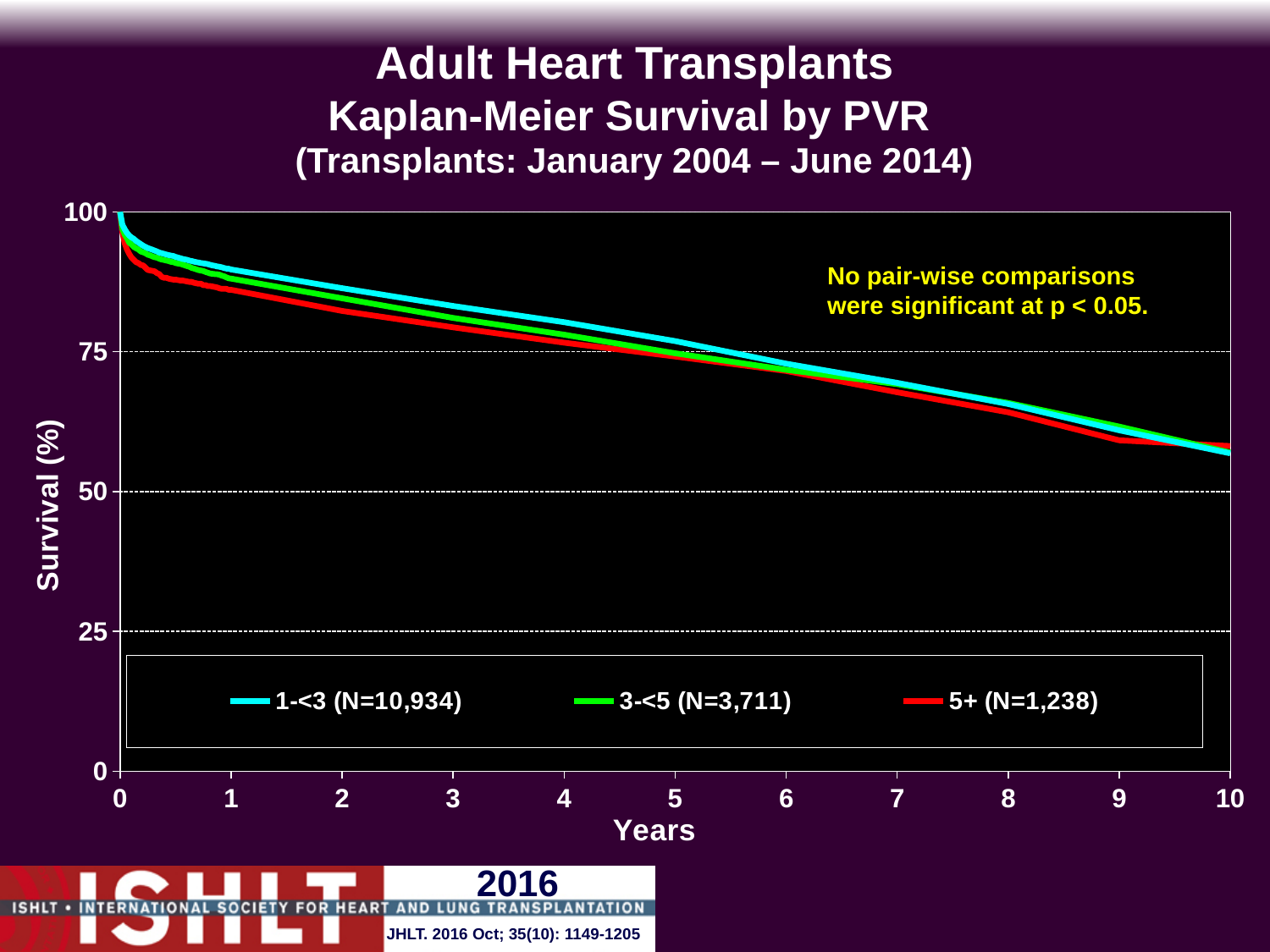
Do the survival curves rise or fall as years increase? fall Is the survival for the 3-<5 group at 1 year greater or less than 75? greater What is the N for the 3-<5 PVR group shown in the legend? 3,711 What kind of chart is shown on the slide? line chart What is the N for the 5+ PVR group shown in the legend? 1,238 What colour is the line for the 1-<3 PVR group? cyan How many series does the legend list? 3 Which PVR group has the lowest survival at 1 year? 5+ Is the survival for the 5+ group at 10 years greater or less than 75? less Which PVR group has the largest number of patients (N) according to the legend? 1-<3 (N=10,934) Is the survival for the 1-<3 group at 10 years greater or less than 50? greater